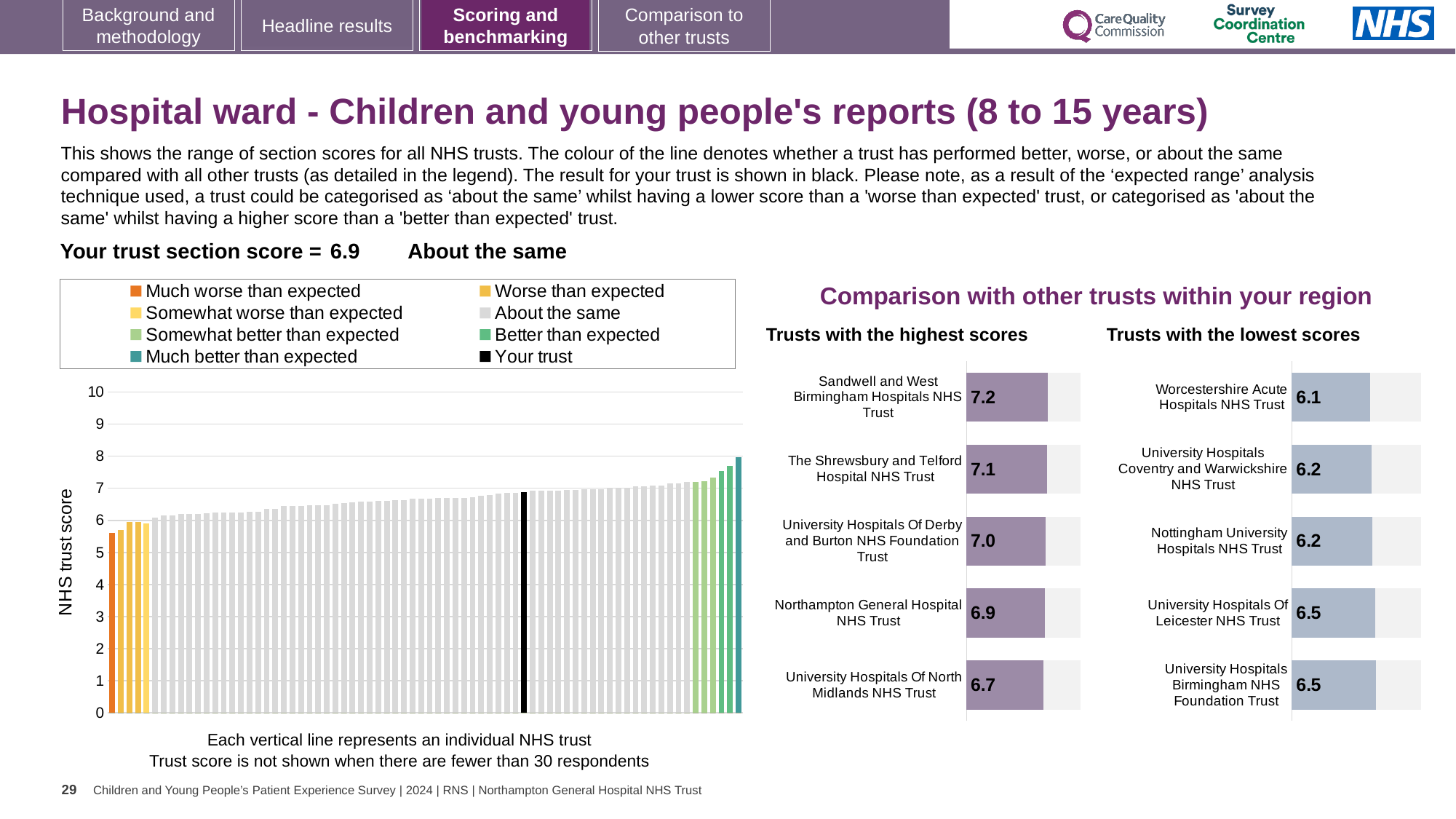
Which is larger: the score for The Shrewsbury and Telford Hospital NHS Trust in the highest scores chart, or the score for Nottingham University Hospitals NHS Trust in the lowest scores chart? The Shrewsbury and Telford Hospital NHS Trust In the 'Trusts with the highest scores' chart, what is the score for Sandwell and West Birmingham Hospitals NHS Trust? 7.2 In the large chart on the left showing all NHS trusts, how many entries does the legend list? 8 In the 'Trusts with the highest scores' chart, what is the difference between the scores of Sandwell and West Birmingham Hospitals NHS Trust and University Hospitals Of North Midlands NHS Trust? 0.5 In the 'Trusts with the lowest scores' chart, what is the score for Worcestershire Acute Hospitals NHS Trust? 6.1 In the large chart on the left showing all NHS trusts, is the value of the leftmost (orange) bar greater or less than 6? less In the 'Trusts with the highest scores' chart, which trust has the lowest score? University Hospitals Of North Midlands NHS Trust In the 'Trusts with the lowest scores' chart, which trust has the lowest score? Worcestershire Acute Hospitals NHS Trust In the 'Trusts with the highest scores' chart, what is the score for Northampton General Hospital NHS Trust? 6.9 In the large chart on the left showing all NHS trusts, what kind of chart is it? Bar chart In the 'Trusts with the lowest scores' chart, what is the difference between the scores of University Hospitals Of Leicester NHS Trust and Worcestershire Acute Hospitals NHS Trust? 0.4 In the 'Trusts with the lowest scores' chart, how many trusts are listed? 5